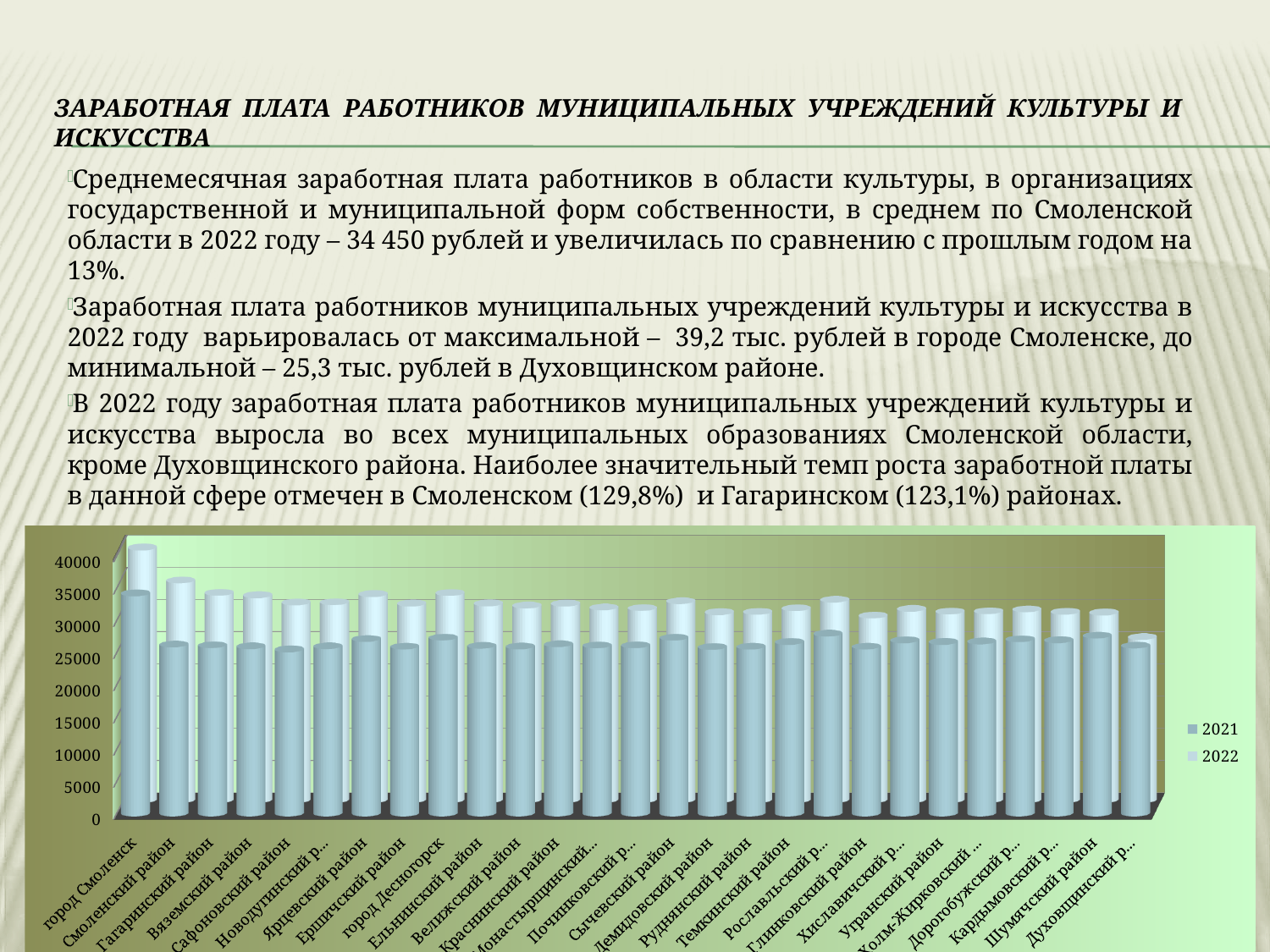
Which series are listed in the chart legend? 2021 and 2022 Which category has the highest value for 2022? город Смоленск Is the 2021 value for город Смоленск greater or less than 30000? greater Is the 2022 value for город Смоленск greater or less than 35000? greater Which category has the lowest value for 2022? Духовщинский район Which is larger: the 2022 value for Смоленский район or the 2022 value for Духовщинский район? Смоленский район How many municipalities (categories) are shown on the x axis of the chart? 27 Which category has the highest value for 2021? город Смоленск What kind of chart is shown on the slide? bar chart For город Смоленск, which is larger: the 2021 value or the 2022 value? 2022 Is the 2022 value for Духовщинский район greater or less than 30000? less How many series does the chart legend list? 2